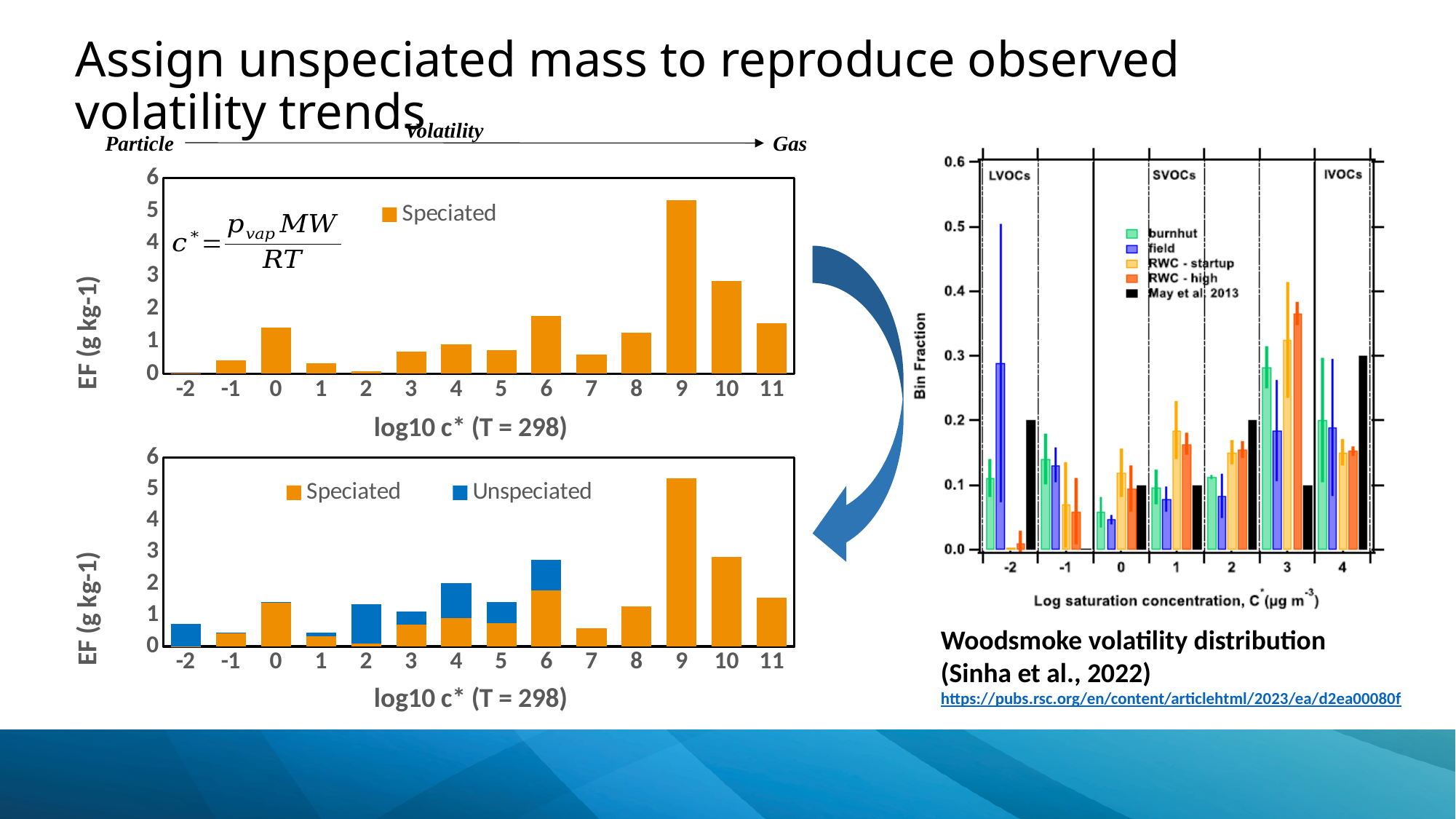
In the top-left chart, which log10 c* bin has the highest Speciated EF? 9 How many log10 c* bins are shown on the x axis of the top-left chart? 14 In the top-left chart, which is larger, the Speciated value at log10 c* = 0 or at log10 c* = 1? 0 What type of chart is the bottom-left chart? bar chart In the top-left chart, is the Speciated value at log10 c* = 10 greater or less than 2? greater In the top-left chart, is the Speciated value at log10 c* = 6 greater or less than 2? less In the bottom-left chart, is the total stacked value at log10 c* = 6 greater or less than 2? greater In the bottom-left chart, which log10 c* bin has the tallest stacked bar? 9 How many series does the legend of the bottom-left chart list? 2 How many series does the legend of the right-hand chart (Woodsmoke volatility distribution) list? 5